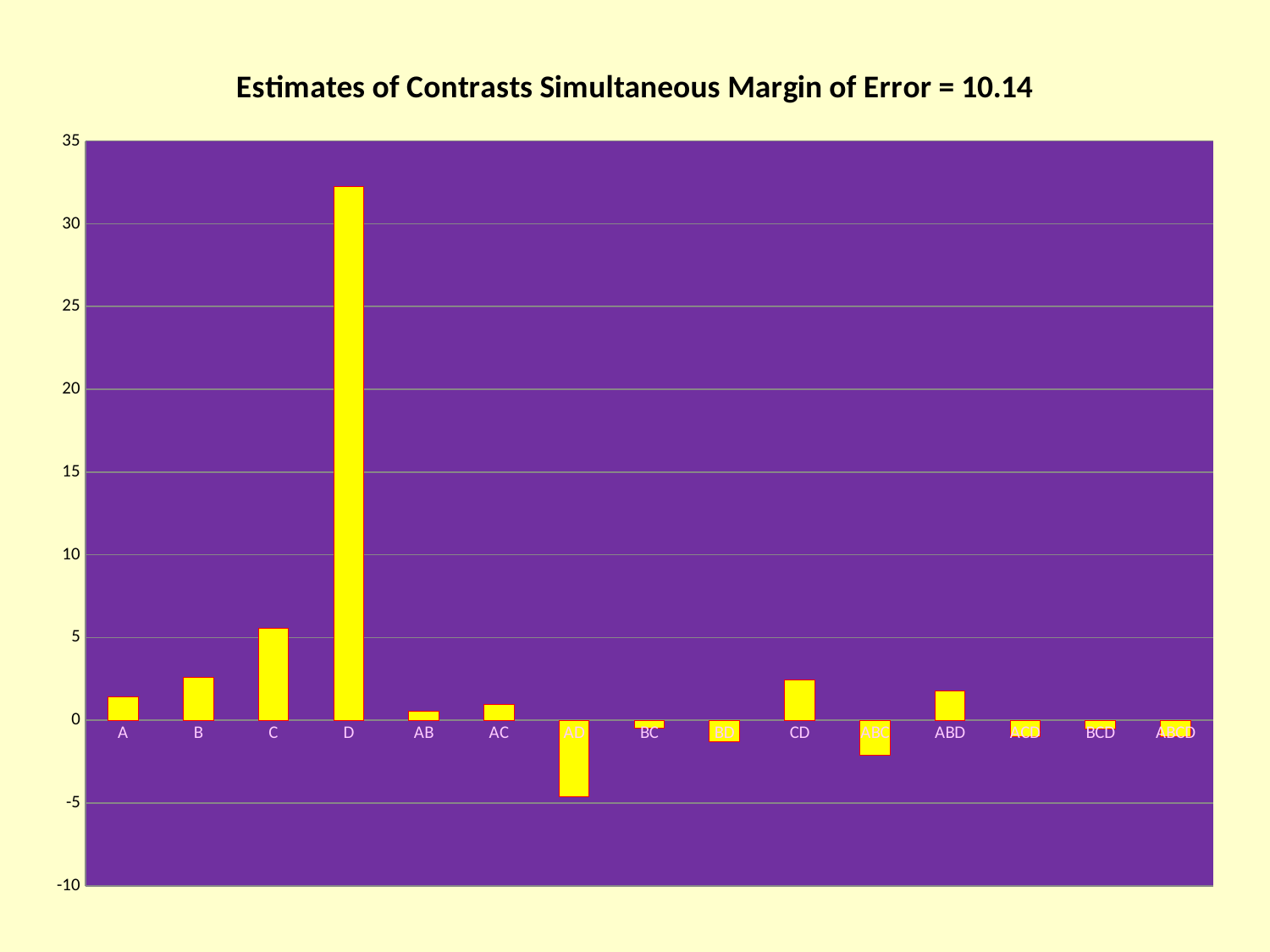
Which is larger, the value for C or the value for CD? C Is the value for D greater or less than 30? greater Is the value for AD greater or less than 0? less What colour are the bars in the chart? yellow Which category has the lowest value? AD What is the title of the chart? Estimates of Contrasts Simultaneous Margin of Error = 10.14 Is the value for C greater or less than 10? less What kind of chart is shown on the slide? bar chart How many categories are plotted along the x axis? 15 Which is larger, the value for B or the value for A? B Which category has the highest value? D